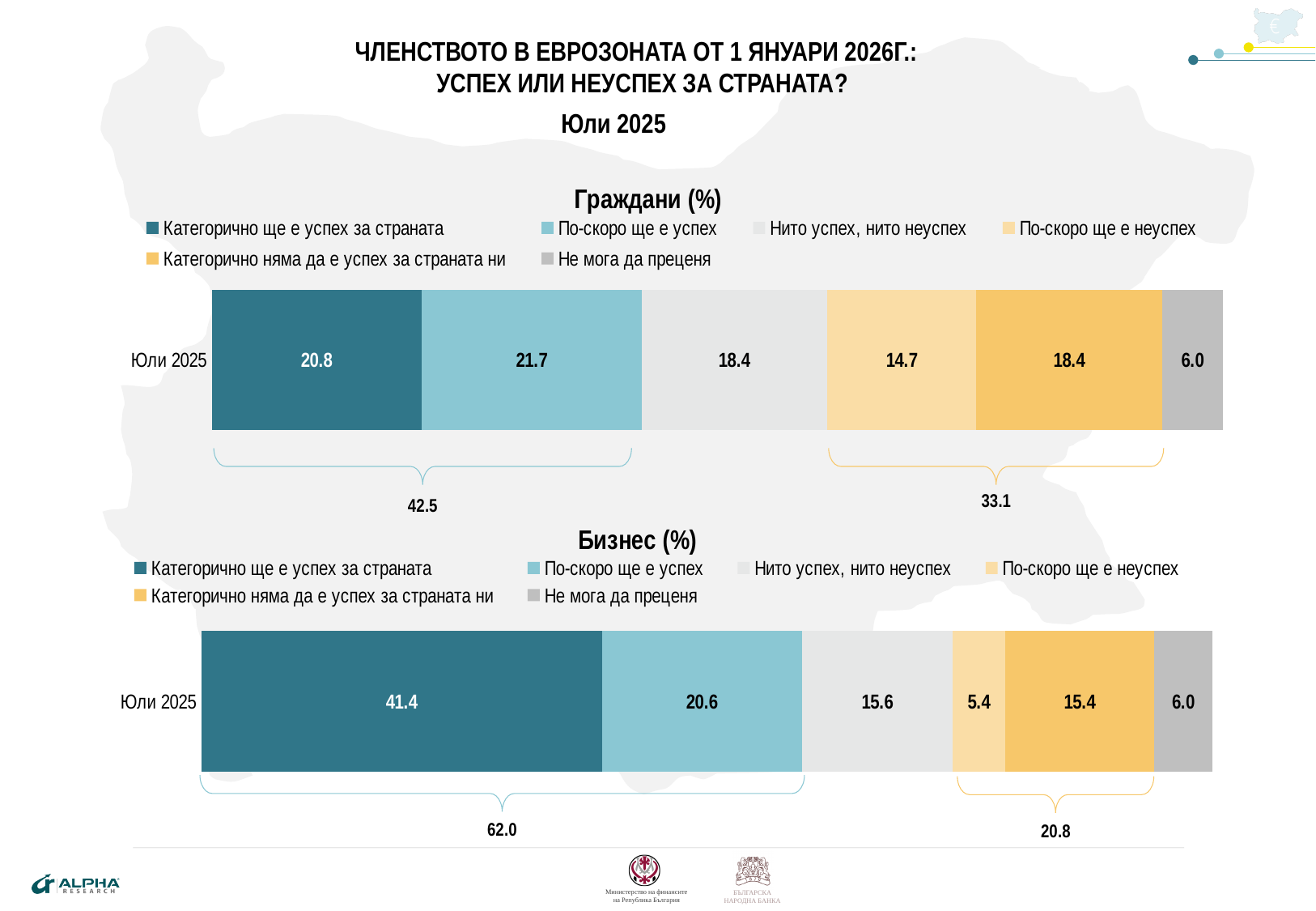
In the "Граждани (%)" chart, which series has the lowest value? Не мога да преценя How many series does the legend of the "Граждани (%)" chart list? 6 What kind of chart is the "Бизнес (%)" chart? Stacked bar chart In the "Граждани (%)" chart, what is the value for "По-скоро ще е неуспех"? 14.7 In the "Бизнес (%)" chart, what is the combined value shown by the bracket under the two "неуспех" segments? 20.8 In the "Граждани (%)" chart, what is the value for "Категорично ще е успех за страната"? 20.8 In the "Граждани (%)" chart, which is larger: "По-скоро ще е успех" or "Категорично ще е успех за страната"? По-скоро ще е успех In the "Бизнес (%)" chart, what is the value for "По-скоро ще е неуспех"? 5.4 In the "Граждани (%)" chart, what is the combined value shown by the bracket under the first two segments? 42.5 In the "Бизнес (%)" chart, what is the difference between "Категорично ще е успех за страната" and "По-скоро ще е успех"? 20.8 In the "Бизнес (%)" chart, which series has the highest value? Категорично ще е успех за страната In the "Бизнес (%)" chart, what is the value for "Категорично ще е успех за страната"? 41.4